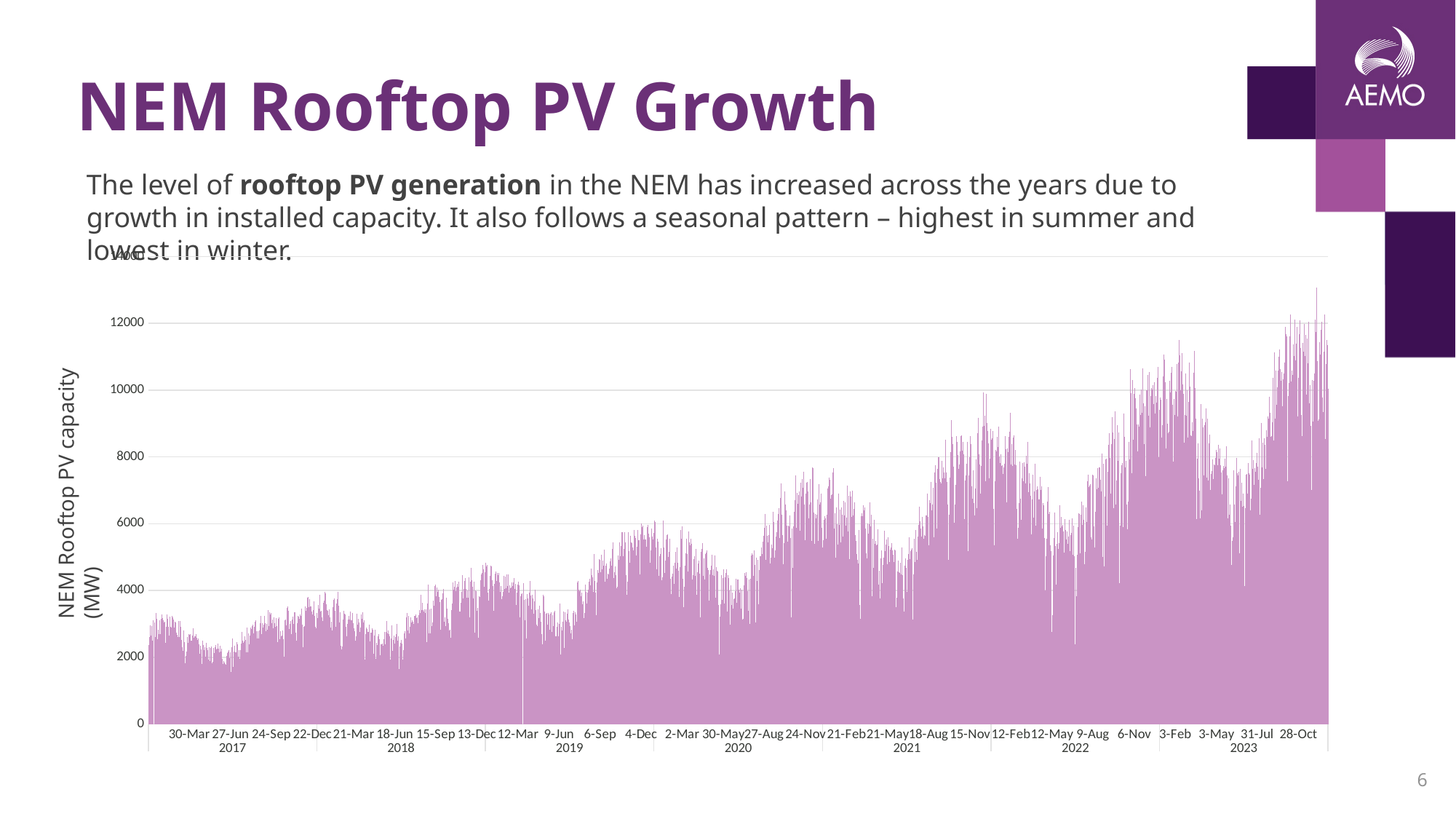
What is the highest value shown on the vertical axis of the chart? 14000 Which year shows the highest peak in NEM rooftop PV capacity? 2023 Is the highest peak reached in late 2023 greater or less than 12000 MW? greater What is the label on the vertical axis of the chart? NEM Rooftop PV capacity (MW) Is the peak reached around the start of 2021 greater or less than 8000 MW? greater Are the peak values in 2023 larger or smaller than the peak values in 2019? Larger Do the plotted values generally rise or fall from 2017 to 2023? Rise What kind of chart is shown on the slide? Area chart Is the peak reached in early 2020 greater or less than 6000 MW? greater How many years are labelled along the x axis of the chart? 7 Which year shows the lowest values of NEM rooftop PV capacity? 2017